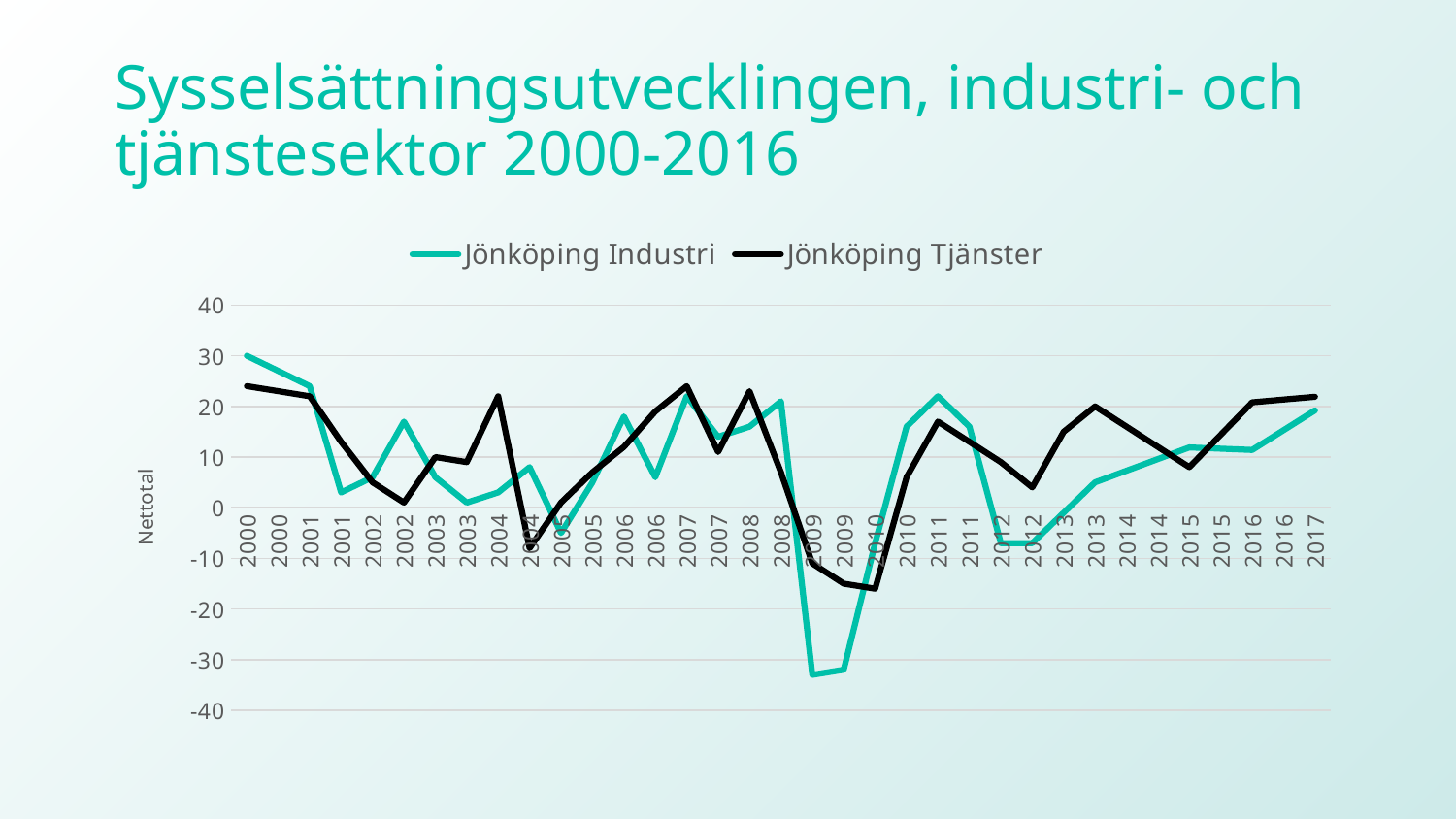
In which year does the Jönköping Tjänster line reach its lowest point? 2010 What are the two series named in the legend? Jönköping Industri and Jönköping Tjänster What is the label on the vertical axis? Nettotal Does the Jönköping Industri line rise or fall from 2012 to 2017? rise What kind of chart is shown on the slide? line chart Is the lowest value of Jönköping Industri greater or less than -30? less In which year does the Jönköping Industri line reach its lowest point? 2009 Which series has the higher value in 2009, Jönköping Industri or Jönköping Tjänster? Jönköping Tjänster Is the first value of Jönköping Industri in 2000 greater or less than 20? greater How many series does the legend list? 2 Is the lowest value of Jönköping Tjänster greater or less than -10? less How many distinct years are labelled on the x axis? 18